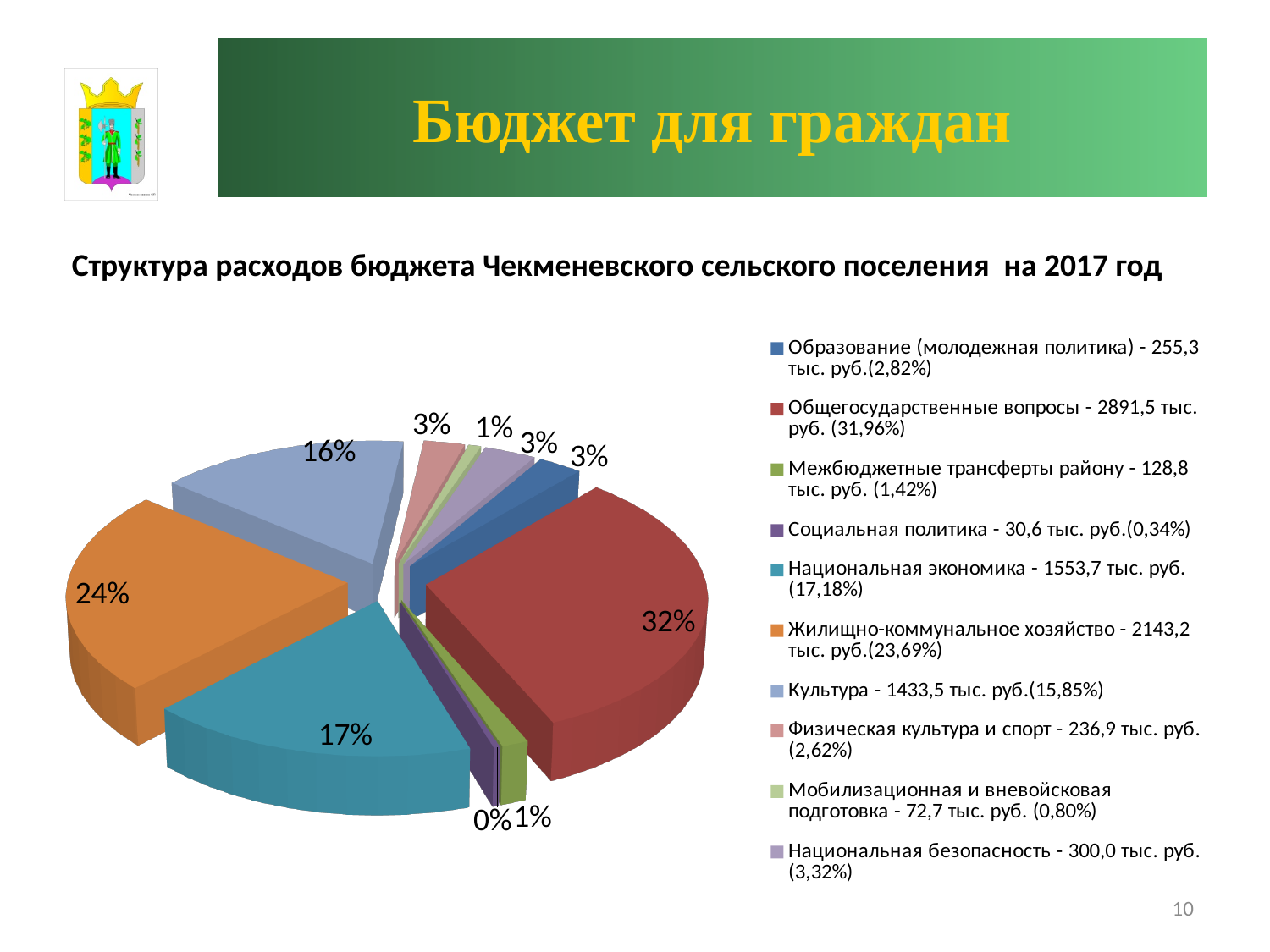
What kind of chart is shown on the slide? Pie chart According to the legend, what is the amount for Национальная безопасность? 300,0 тыс. руб. What is the difference in thousand rubles between Общегосударственные вопросы (2891,5) and Жилищно-коммунальное хозяйство (2143,2)? 748,3 тыс. руб. How many categories does the legend of the pie chart list? 10 Which category has the smallest share of the pie? Социальная политика According to the legend, what is the exact share of Общегосударственные вопросы? 31,96% What percentage label is shown on the slice for Жилищно-коммунальное хозяйство? 24% According to the legend, what is the amount for Культура in thousand rubles? 1433,5 тыс. руб. Which category has the largest share of the pie? Общегосударственные вопросы What is the title of the chart on the slide? Структура расходов бюджета Чекменевского сельского поселения на 2017 год Which is larger: the share for Культура or the share for Национальная экономика? Национальная экономика What percentage label is shown on the slice for Национальная экономика? 17%